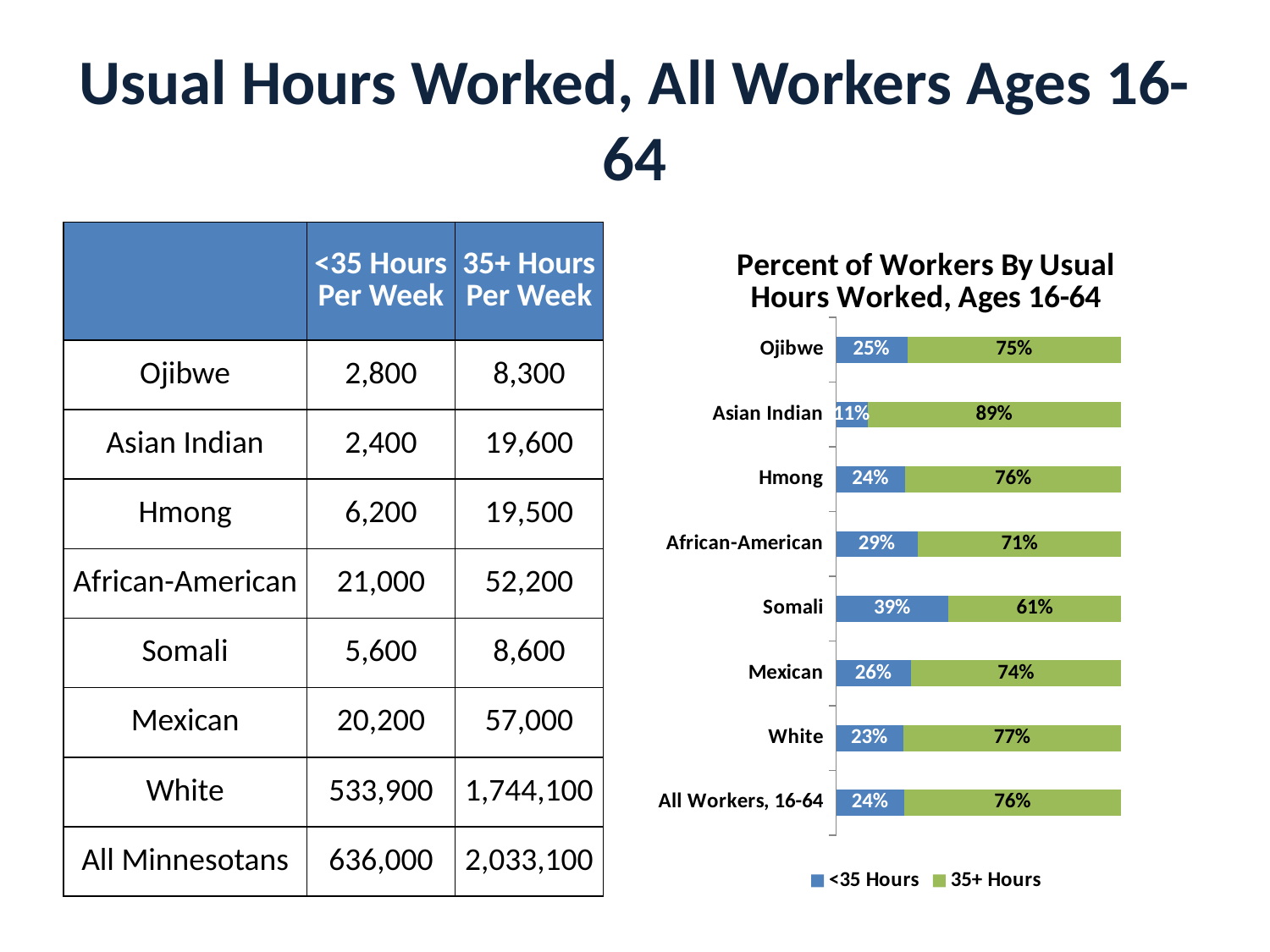
Which colour represents the 35+ Hours series in the chart? Green How many groups are shown on the chart? 8 How many series does the chart legend list? 2 Which group has the lowest share of workers working fewer than 35 hours per week? Asian Indian What is the title of the chart? Percent of Workers By Usual Hours Worked, Ages 16-64 What percentage of Somali workers usually work 35+ hours per week according to the chart? 61% What is the difference between the 35+ Hours percentage for Asian Indian and for Somali workers? 28 percentage points What kind of chart is shown on the slide? Stacked horizontal bar chart What percentage of Asian Indian workers usually work fewer than 35 hours per week according to the chart? 11% Which group has a larger share of workers working 35+ hours per week, Hmong or African-American? Hmong Which group has the highest share of workers working fewer than 35 hours per week? Somali What is the total of the two segments in the bar for White workers? 100%